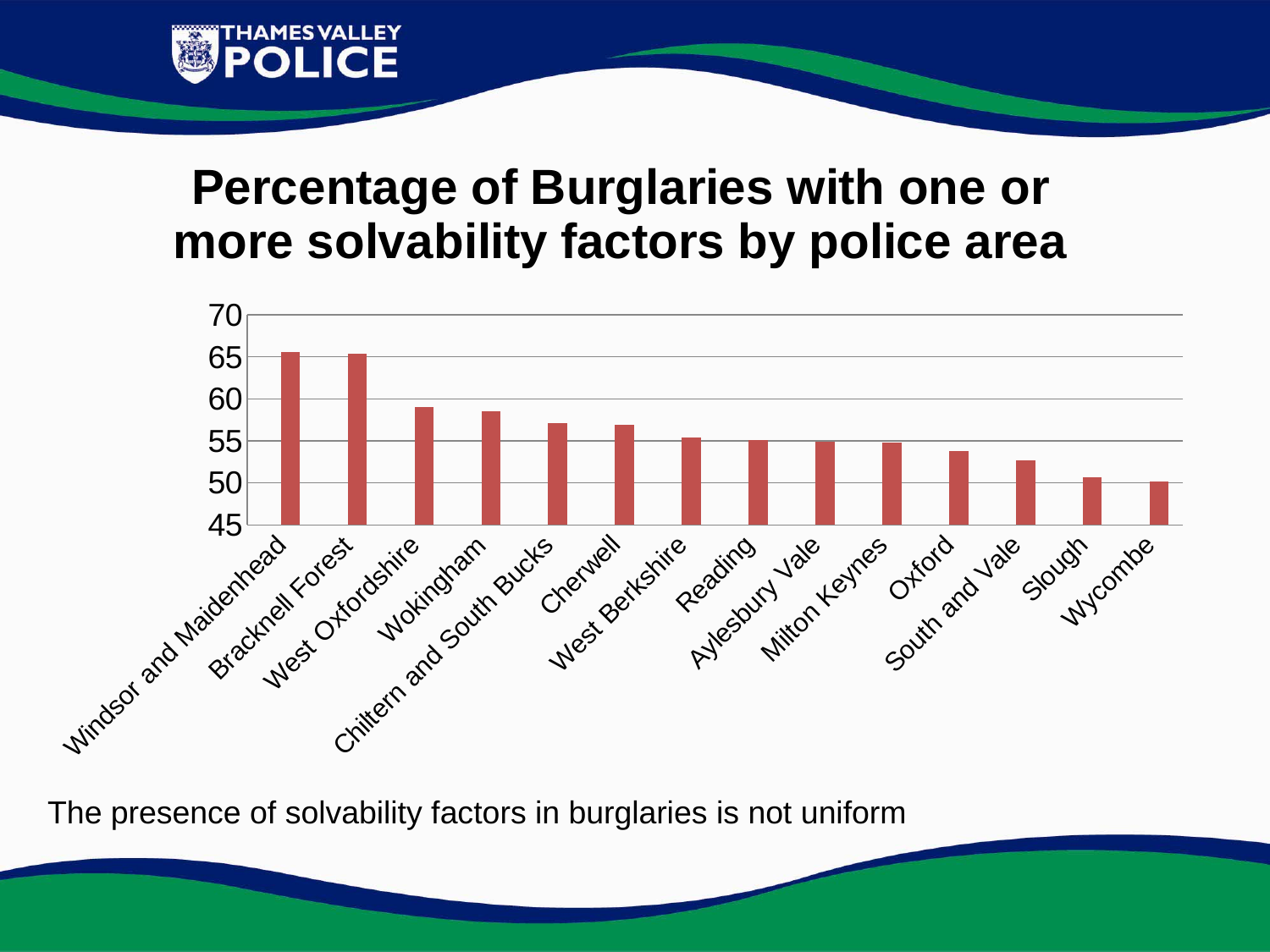
Is the value for West Oxfordshire greater or less than 60? less Which has the larger value, Windsor and Maidenhead or Wycombe? Windsor and Maidenhead What is the title of the chart? Percentage of Burglaries with one or more solvability factors by police area What kind of chart is shown on the slide? bar chart Is the value for Wokingham greater or less than 55? greater How many police areas are shown on the x axis of the chart? 14 Is the value for Bracknell Forest greater or less than 60? greater Which has the larger value, West Oxfordshire or Oxford? West Oxfordshire Do the values rise or fall moving from left to right along the x axis? fall